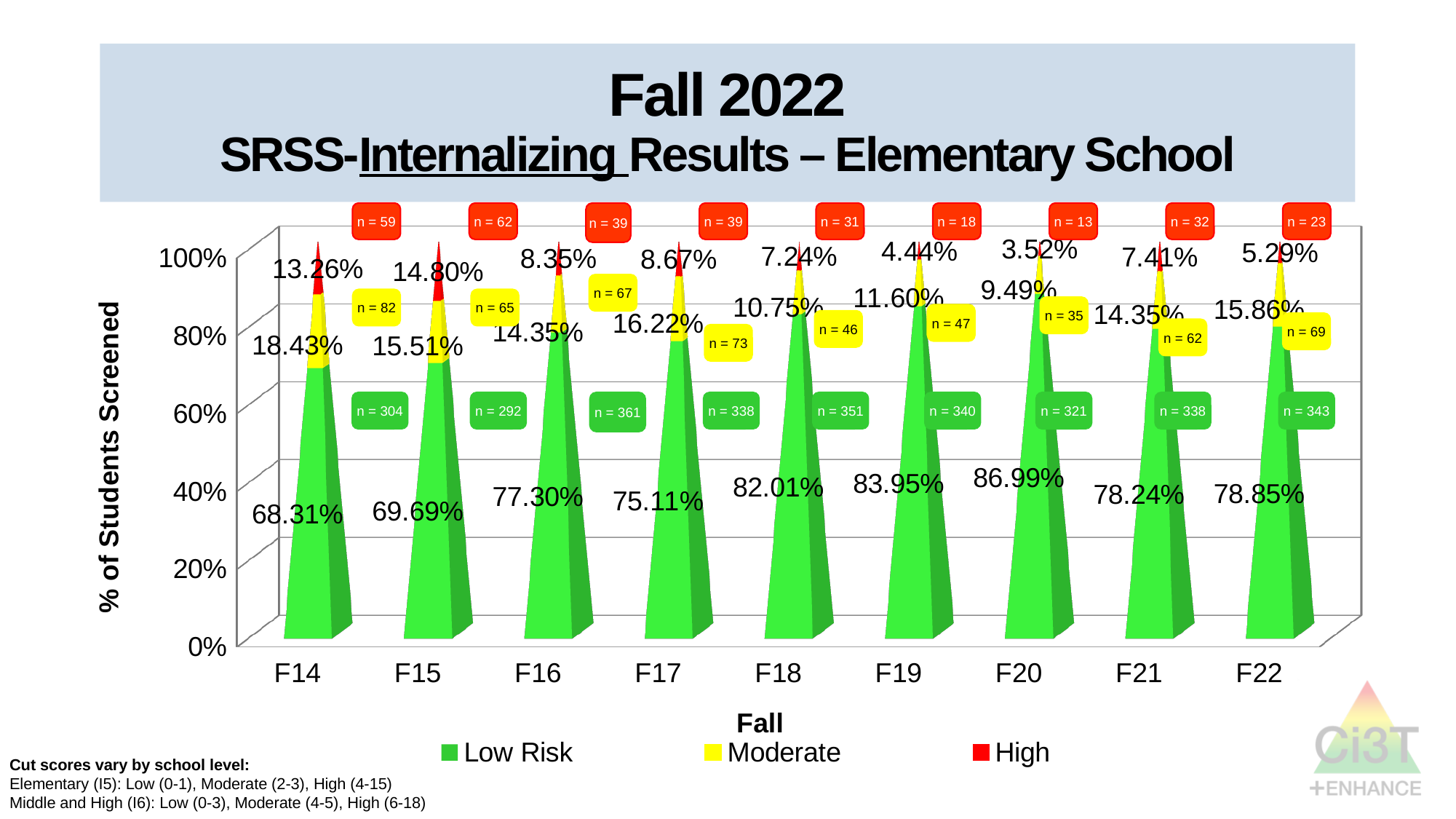
What is the difference between the Low Risk percentage for F20 and for F14? 18.68% What kind of chart is shown on the slide? Stacked bar chart How many series does the legend list? 3 What is the Moderate percentage for F22? 15.86% Which fall has the lowest High percentage? F20 What is the n value shown for the Low Risk group in F16? n = 361 Which fall has the highest Low Risk percentage? F20 Which is larger, the Moderate percentage for F14 or for F18? F14 What is the Low Risk percentage for F14? 68.31% What is the High percentage for F15? 14.80% Which colour represents the High risk group in the legend? Red How many fall screening periods are shown on the x axis? 9